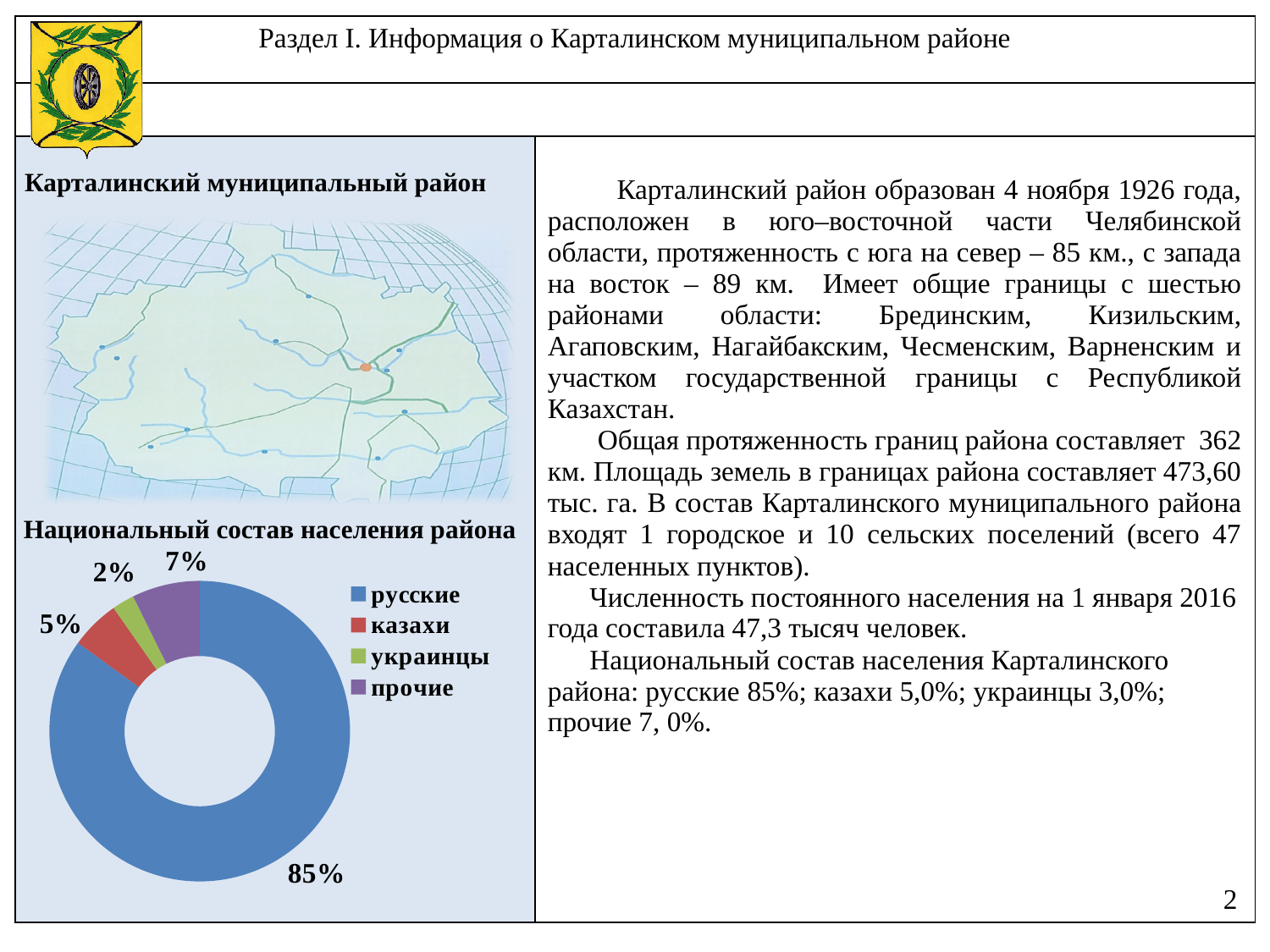
What colour is the segment for русские in the chart? blue What share of the population is labelled for украинцы in the chart? 2% What is the title of the chart on the slide? Национальный состав населения района Which category has the largest share in the chart? русские What share of the population is labelled for прочие in the chart? 7% What share of the population is labelled for казахи in the chart? 5% How many categories does the legend of the chart list? 4 Which is larger in the chart, the share for казахи or the share for прочие? прочие What is the difference between the share for русские and the share for прочие in the chart? 78% What type of chart is used to show the national composition of the district's population? doughnut chart What share of the population is labelled for русские in the chart? 85% Which category has the smallest share in the chart? украинцы